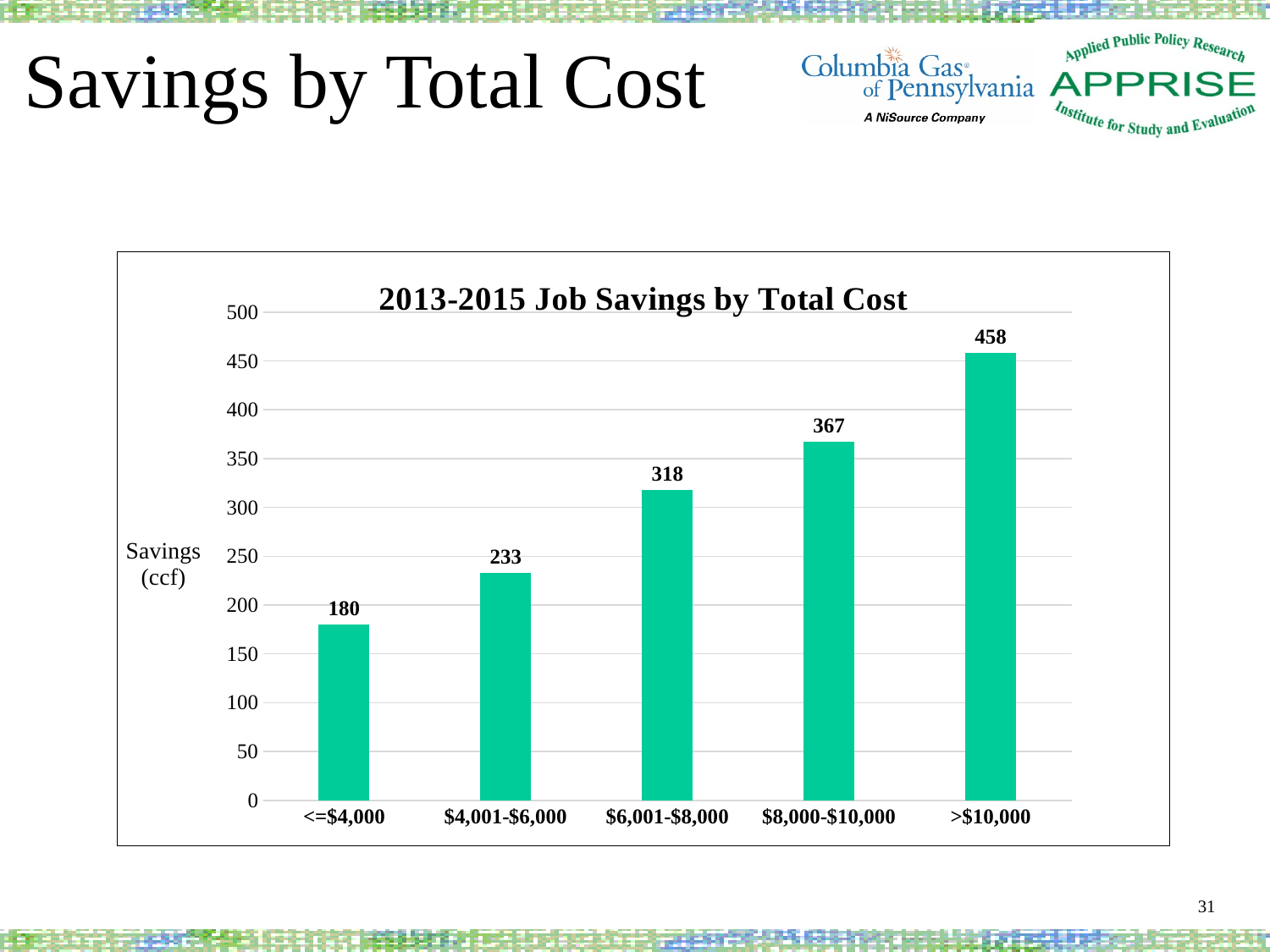
What is the difference in savings between the >$10,000 and <=$4,000 categories? 278 Which cost category has the highest savings? >$10,000 What kind of chart is shown on the slide? Bar chart What is the difference in savings between the $8,000-$10,000 and $4,001-$6,000 categories? 134 What is the savings value for the <=$4,000 cost category? 180 Which cost category has the lowest savings? <=$4,000 Which has higher savings: $4,001-$6,000 or $6,001-$8,000? $6,001-$8,000 Is the savings value for $8,000-$10,000 greater or less than 350? greater Do the savings values rise or fall as total cost increases along the x axis? Rise How many cost categories are shown in the chart? 5 What is the savings value for the $6,001-$8,000 cost category? 318 What is the savings value for the >$10,000 cost category? 458